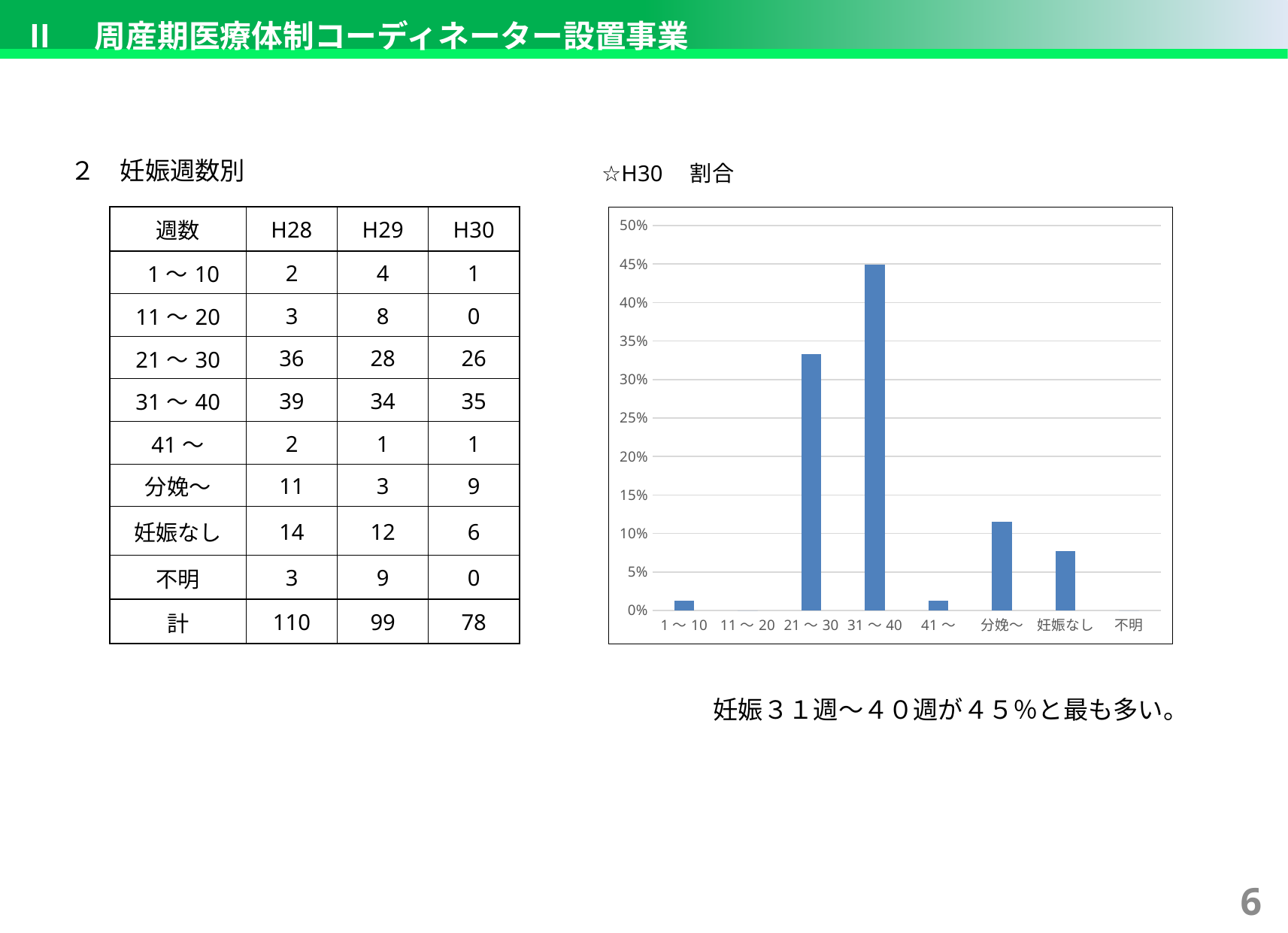
Which is larger, the value for 21 〜 30 or the value for 分娩〜? 21 〜 30 Is the value for 妊娠なし greater or less than 10%? less What is the highest value shown on the y axis of the chart? 50% How many categories are shown on the x axis of the chart? 8 Is the value for 分娩〜 greater or less than 10%? greater What is the title of the chart? ☆H30 割合 Is the value for 21 〜 30 greater or less than 30%? greater Which category has the highest value in the chart? 31 〜 40 Which is larger, the value for 分娩〜 or the value for 妊娠なし? 分娩〜 What kind of chart is shown on the slide? bar chart